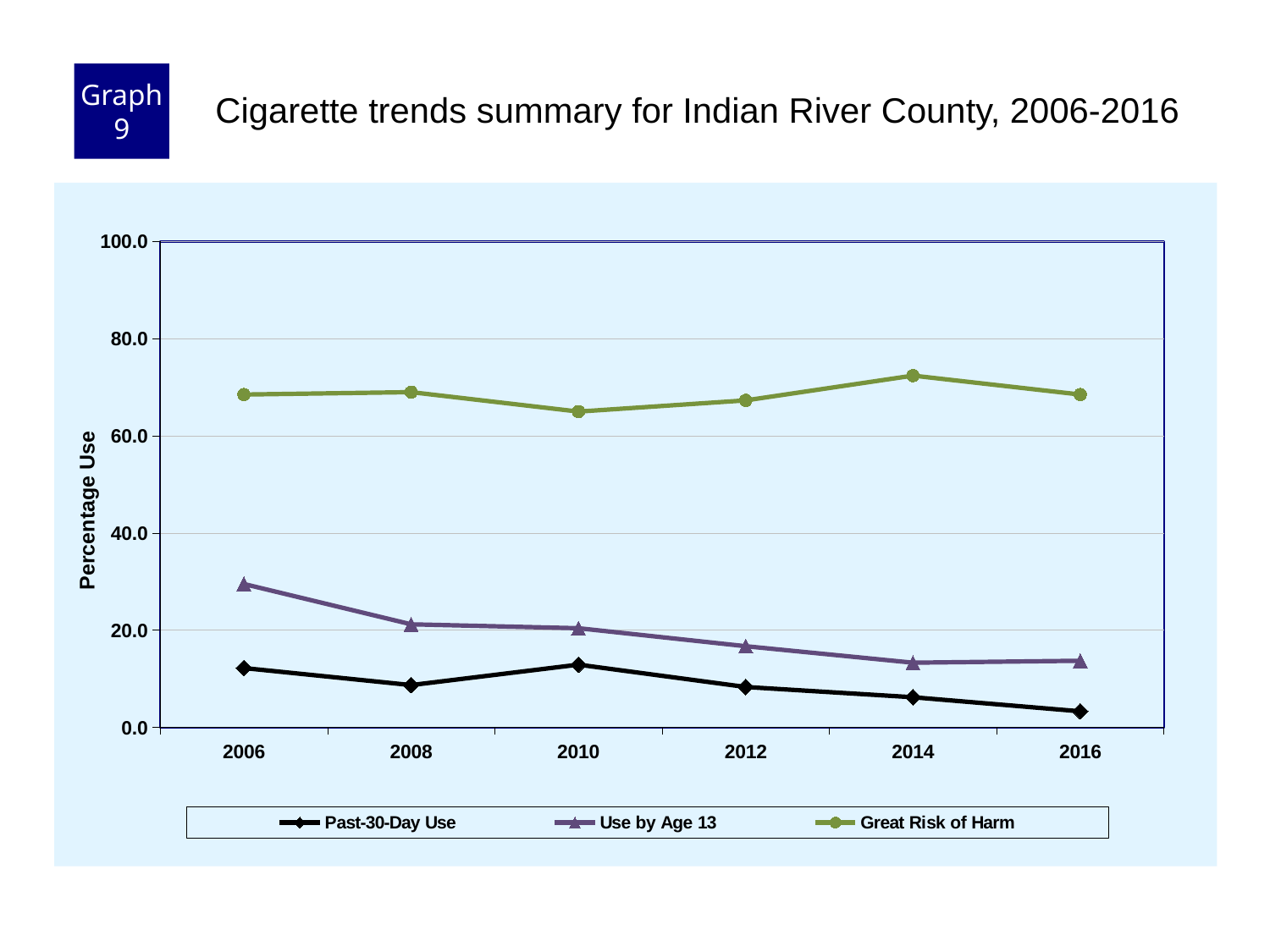
In which year is the Great Risk of Harm series at its highest? 2014 In which year is the Past-30-Day Use series at its lowest? 2016 In which year is the Great Risk of Harm series at its lowest? 2010 Does the Use by Age 13 series generally rise or fall from 2006 to 2016? fall How many years are plotted along the x axis? 6 What is the label on the vertical axis? Percentage Use For Past-30-Day Use, which year has the larger value, 2008 or 2010? 2010 How many series does the legend list? 3 Is the value for Use by Age 13 in 2006 greater or less than 20.0? greater In which year is the Use by Age 13 series at its highest? 2006 Is the value for Great Risk of Harm in 2014 greater or less than 80.0? less What kind of chart is shown on the slide? line chart